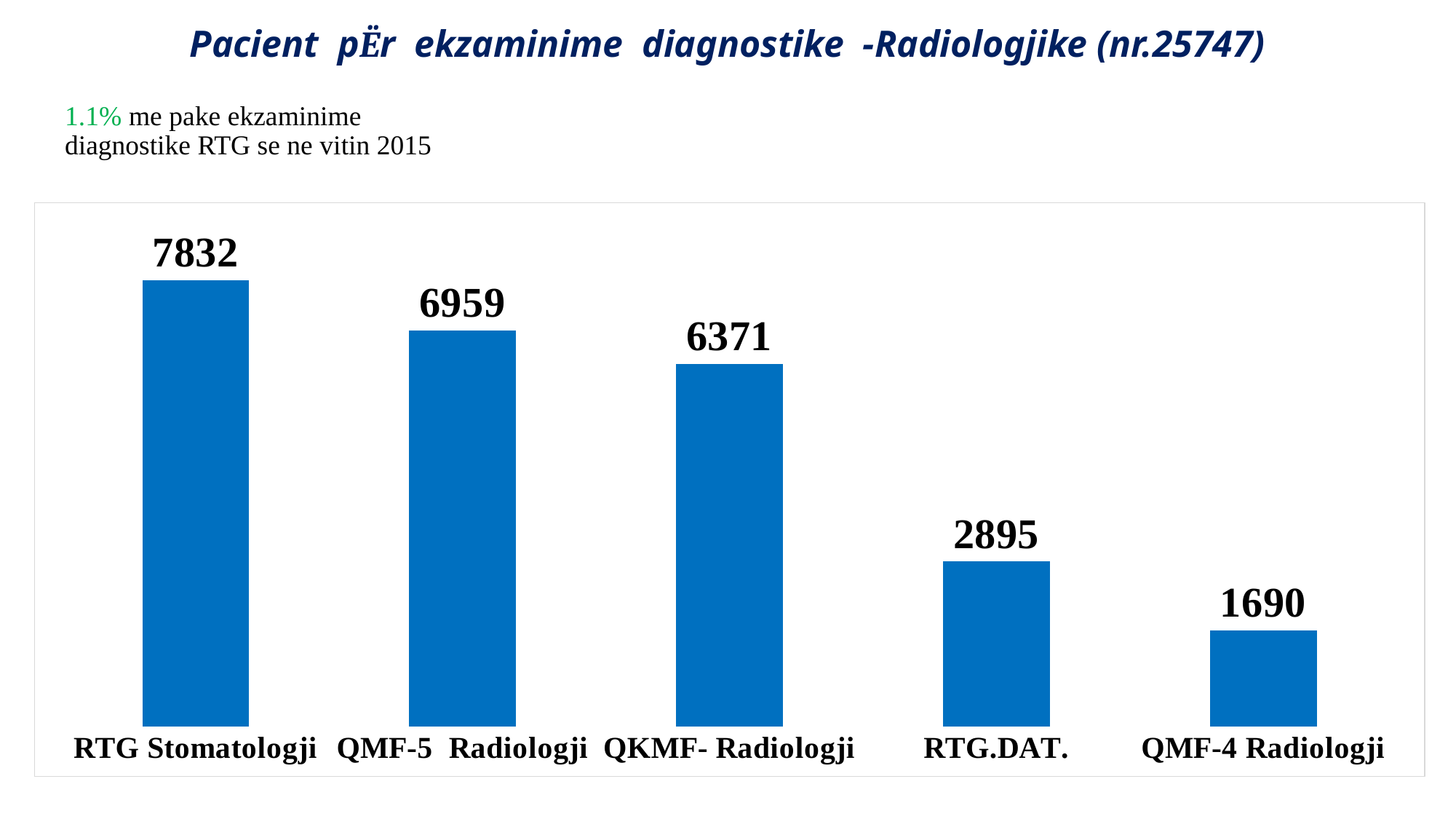
What is the value for RTG.DAT.? 2895 How many categories are shown in the chart? 5 Which is larger, the value for QKMF- Radiologji or the value for RTG.DAT.? QKMF- Radiologji What is the value for RTG Stomatologji? 7832 What is the value for QKMF- Radiologji? 6371 What is the difference between the values for RTG Stomatologji and QMF-5 Radiologji? 873 What is the value for QMF-4 Radiologji? 1690 What kind of chart is shown on the slide? Bar chart What is the value for QMF-5 Radiologji? 6959 Which category has the highest value? RTG Stomatologji What is the difference between the values for RTG.DAT. and QMF-4 Radiologji? 1205 Which category has the lowest value? QMF-4 Radiologji